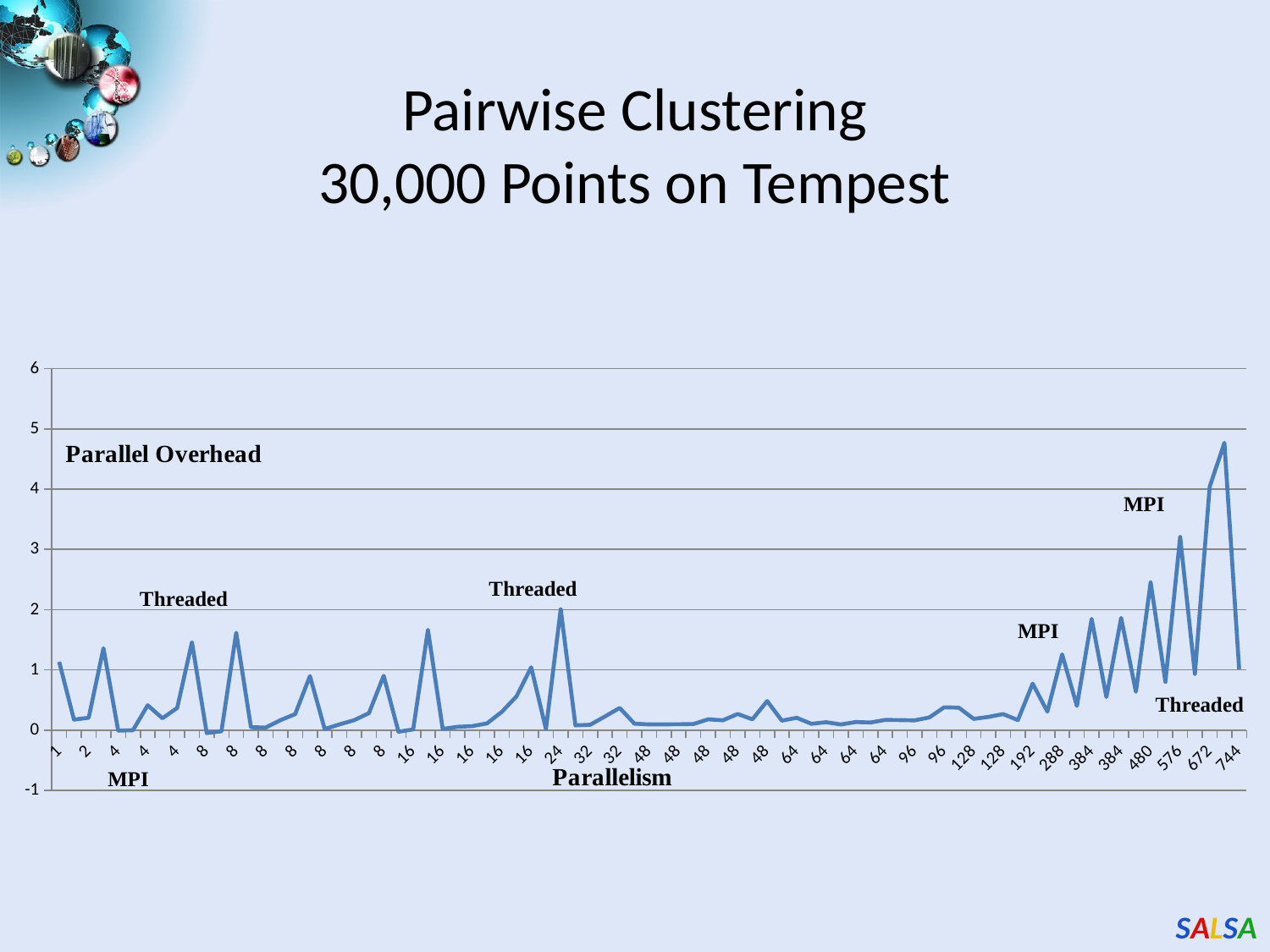
What is the label on the x axis of the chart? Parallelism In which region of the x axis does the line reach its highest value: the left (parallelism 1-8), the middle (parallelism 32-128), or the right (parallelism 384-744)? the right (parallelism 384-744) What kind of chart is shown on the slide? line chart Is the peak of the line at the x-axis label 16 (the tallest peak in the 16 group) greater or less than 1? greater What is the title of the slide containing the chart? Pairwise Clustering 30,000 Points on Tempest Which is larger: the value of the line at the x-axis label 48 or the peak at the x-axis label 576? the peak at 576 Do the peaks of the line generally rise or fall as parallelism increases from 192 to 744? rise Is the highest peak of the line, near the right end of the chart, greater or less than 4? greater Is the peak of the line at the x-axis label 576 greater or less than 2? greater Which is larger: the peak of the line near the x-axis label 744 or the peak near the x-axis label 24? the peak near 744